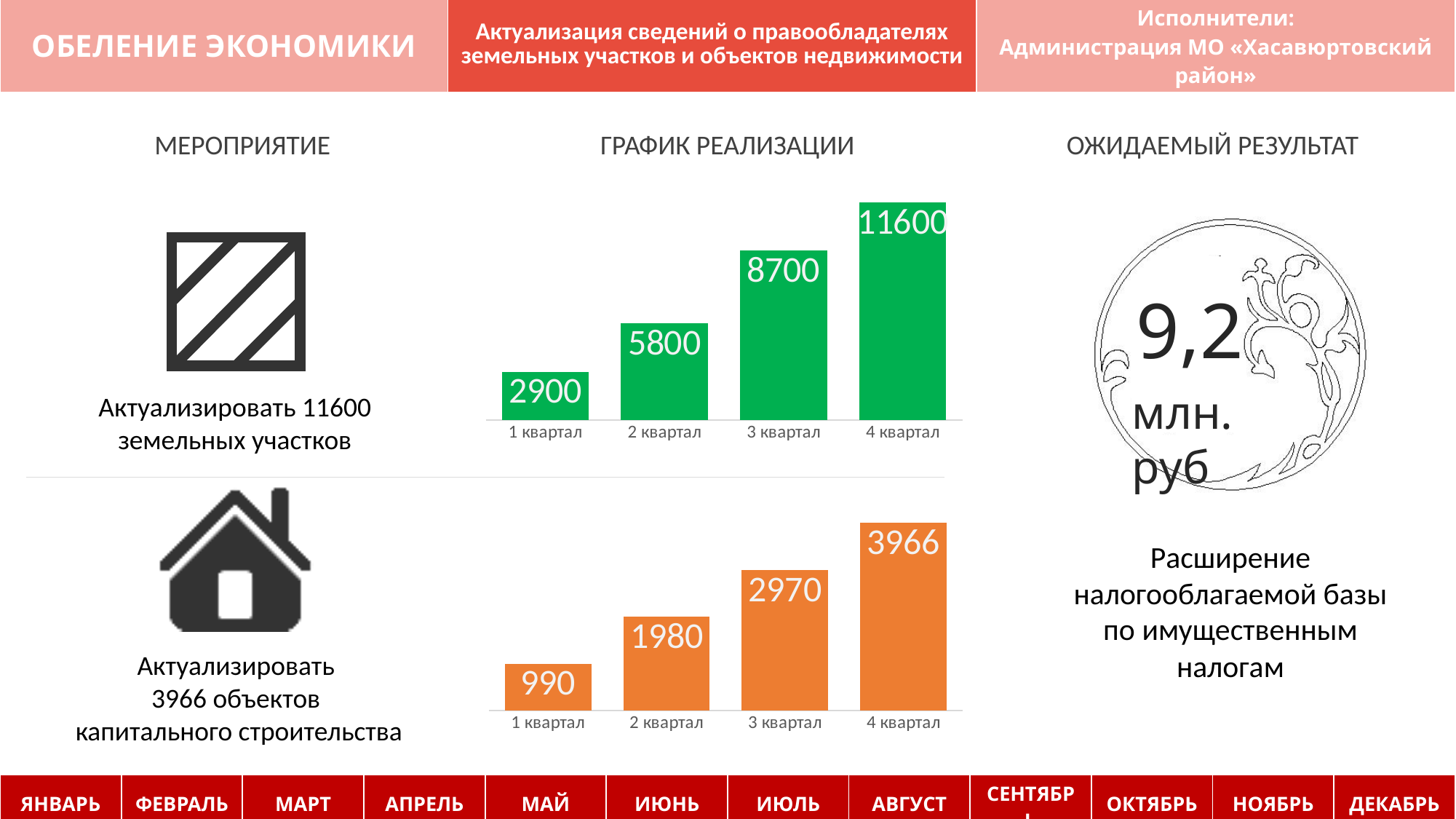
In the upper (green) chart, what is the value for 2 квартал? 5800 What kind of chart is the lower (orange) chart? bar chart In the upper (green) chart, what is the difference between the values for 4 квартал and 3 квартал? 2900 In the lower (orange) chart, what is the value for 3 квартал? 2970 In the lower (orange) chart, which is larger: the value for 4 квартал or 3 квартал? 4 квартал How many bars are in the upper (green) chart? 4 In the upper (green) chart, which quarter has the highest value? 4 квартал In the upper (green) chart, do the values rise or fall from 1 квартал to 4 квартал? rise In the lower (orange) chart, what is the difference between the values for 2 квартал and 1 квартал? 990 What colour are the bars in the upper chart? green In the lower (orange) chart, which quarter has the lowest value? 1 квартал In the lower (orange) chart, what is the value for 4 квартал? 3966